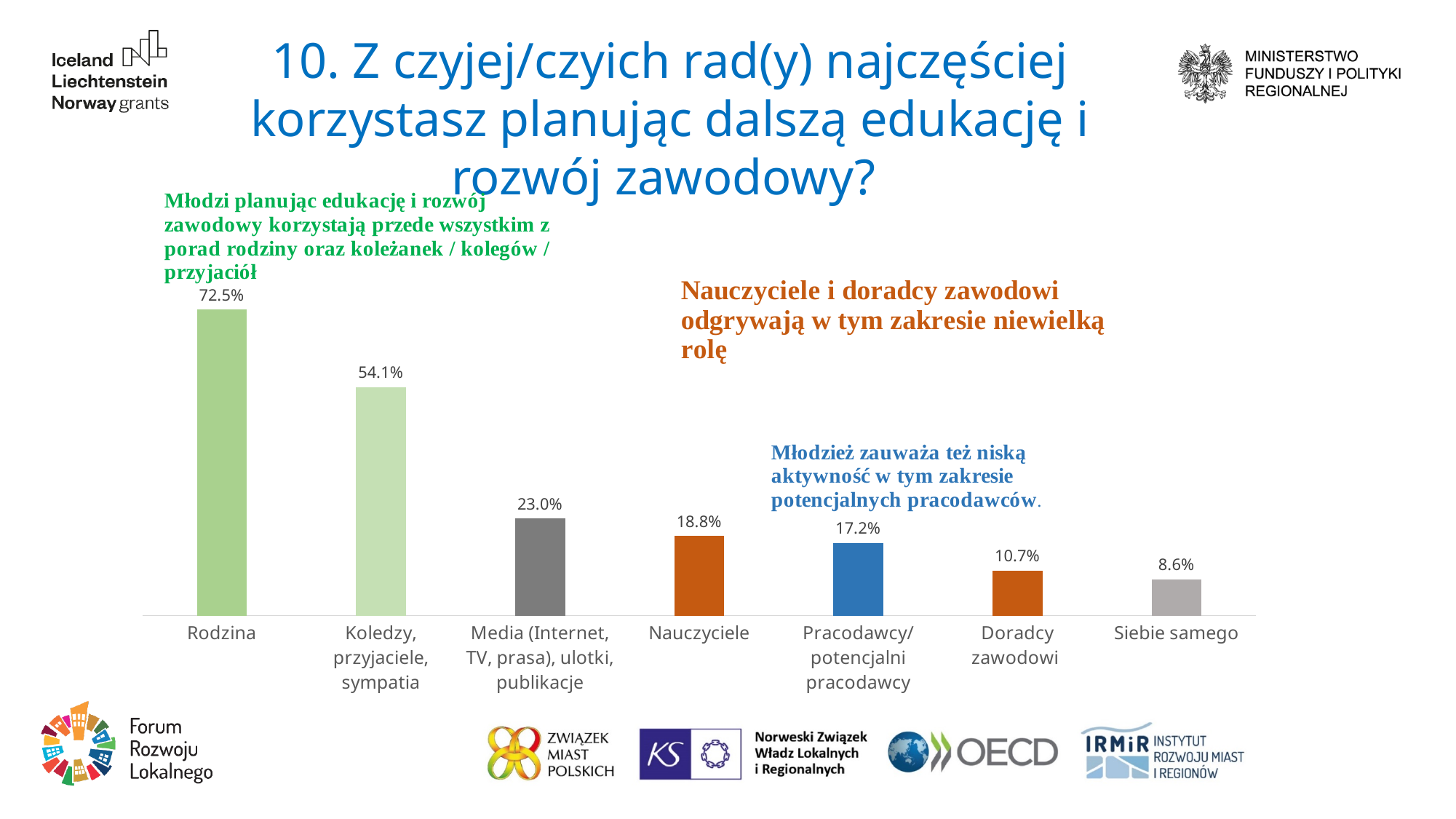
What is the difference between the values for Rodzina and Koledzy, przyjaciele, sympatia? 18.4% What is the value for Doradcy zawodowi? 10.7% Which is larger, the value for Nauczyciele or the value for Pracodawcy/ potencjalni pracodawcy? Nauczyciele Which category has the lowest value? Siebie samego Do the values rise or fall from left to right along the x axis? Fall What is the value for Rodzina? 72.5% How many categories are shown in the chart? 7 What is the value for Nauczyciele? 18.8% What is the value for Siebie samego? 8.6% What kind of chart is shown on the slide? Bar chart Which category has the highest value? Rodzina What is the difference between the values for Media (Internet, TV, prasa), ulotki, publikacje and Doradcy zawodowi? 12.3%